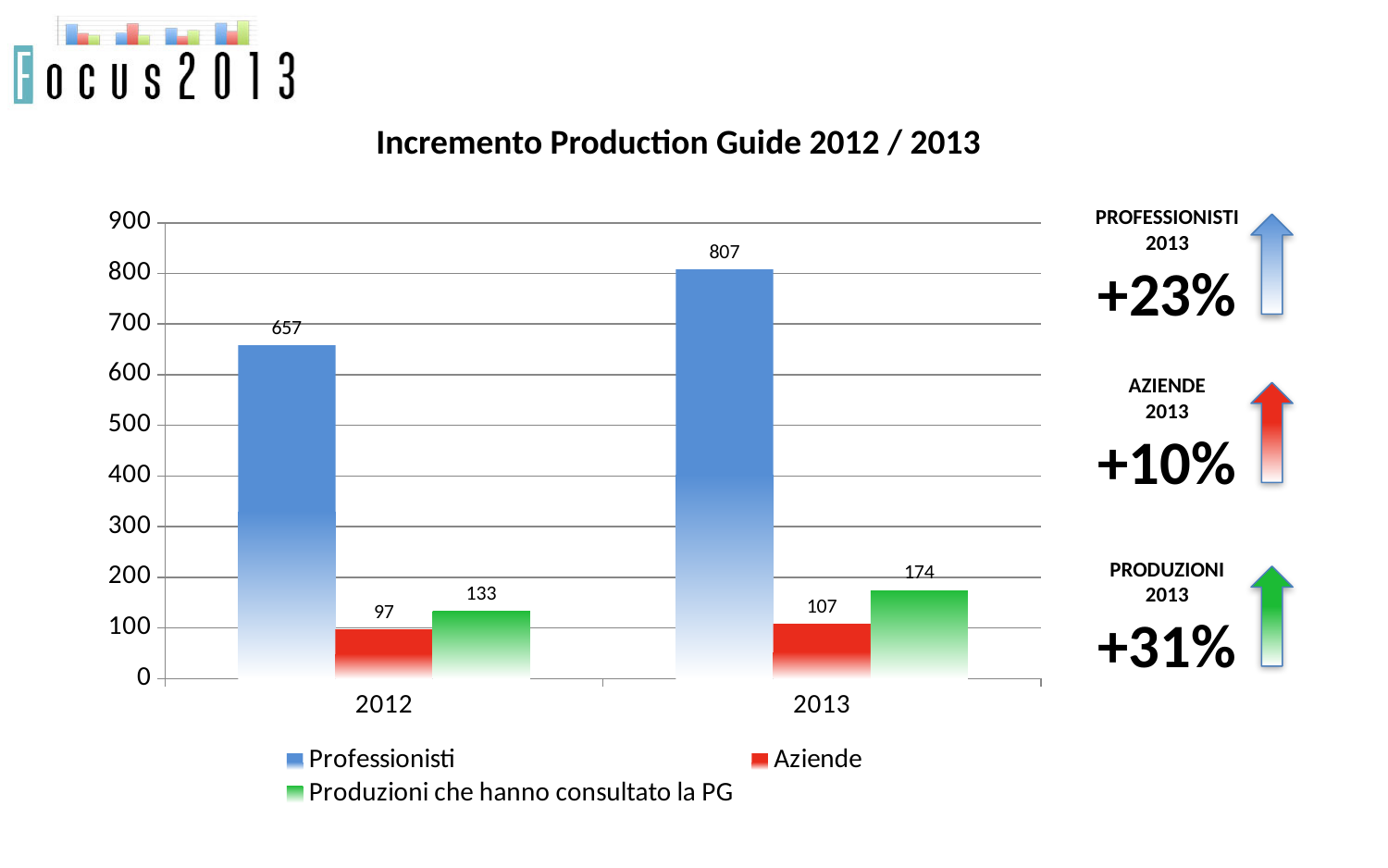
Which series has the lowest value in 2013? Aziende What kind of chart is shown on the slide? bar chart What is the difference between the Produzioni che hanno consultato la PG values for 2013 and 2012? 41 What is the value for Aziende in 2012? 97 What is the title of the chart? Incremento Production Guide 2012 / 2013 What is the value for Produzioni che hanno consultato la PG in 2013? 174 Is the value for Professionisti in 2012 greater or less than 600? greater What is the value for Professionisti in 2013? 807 What is the difference between the Professionisti values for 2013 and 2012? 150 How many series does the legend list? 3 Which is larger, Aziende in 2013 or Produzioni che hanno consultato la PG in 2012? Produzioni che hanno consultato la PG in 2012 Which series has the highest value in 2012? Professionisti